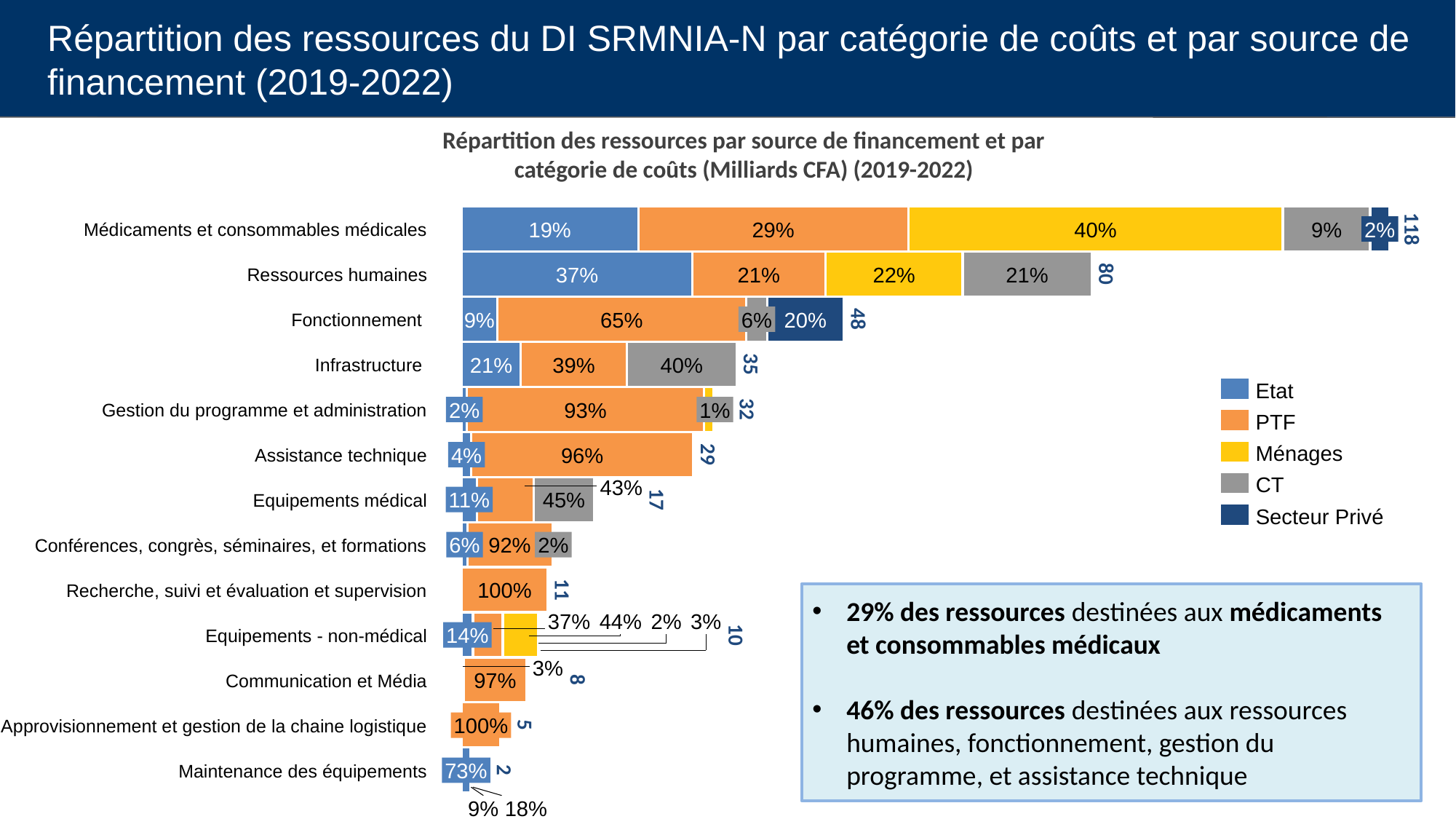
How many cost categories are plotted on the chart? 13 What kind of chart is shown on the slide? Stacked bar chart What is the Ménages share for Médicaments et consommables médicales? 40% How many series does the legend list? 5 Which cost category has the lowest total in Milliards CFA? Maintenance des équipements What is the Etat share for Ressources humaines? 37% Which cost category has the highest total in Milliards CFA? Médicaments et consommables médicales What is the total (Milliards CFA) shown for Infrastructure? 35 Which has a larger total: Ressources humaines or Fonctionnement? Ressources humaines What is the Secteur Privé share for Fonctionnement? 20% What is the difference between the totals for Médicaments et consommables médicales and Ressources humaines? 38 What is the PTF share for Fonctionnement? 65%